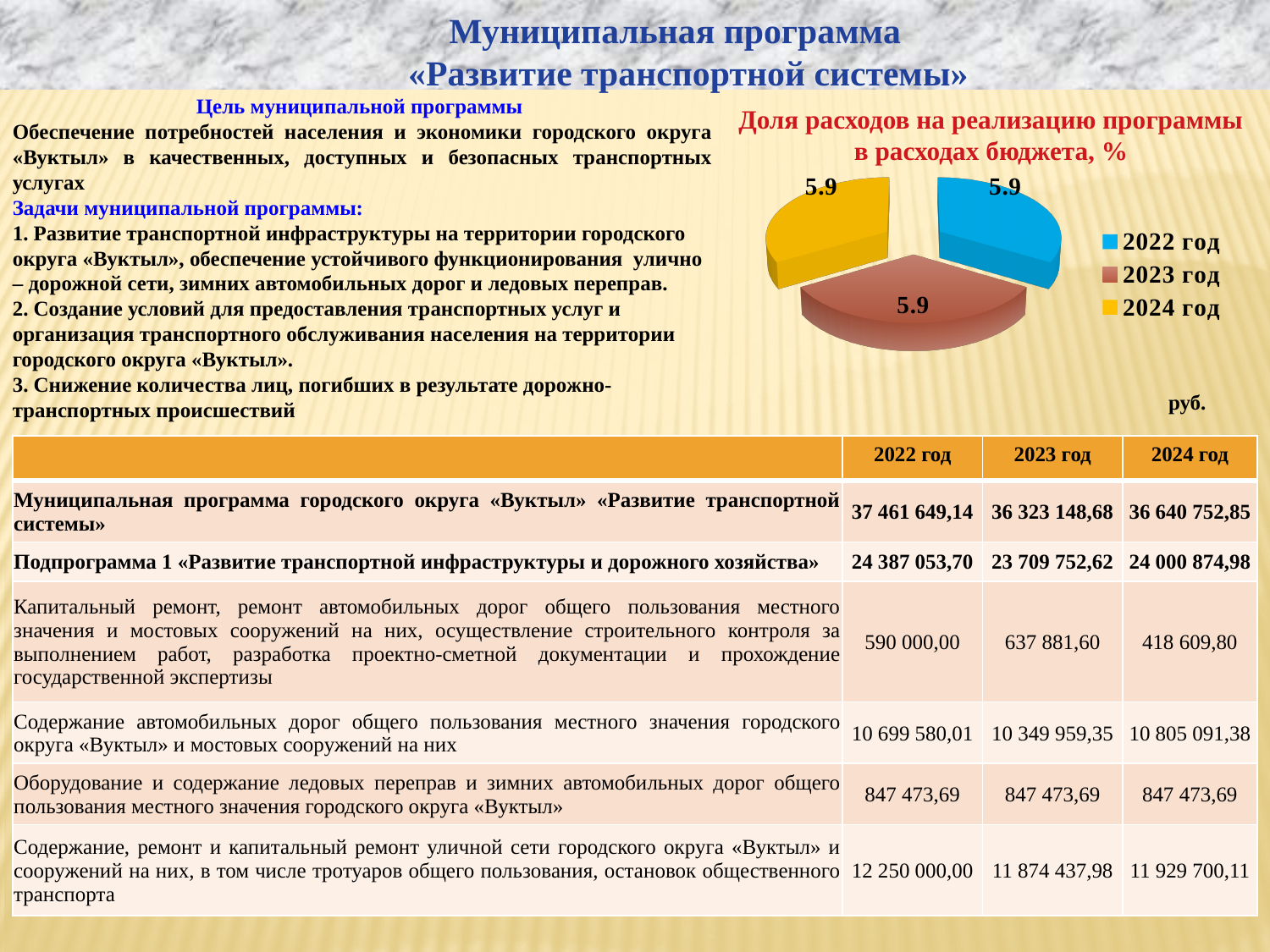
What is the value shown for 2024 год in the pie chart? 5.9 How many slices does the pie chart have? 3 How many entries does the legend of the pie chart list? 3 What is the value shown for 2023 год in the pie chart? 5.9 What is the value shown for 2022 год in the pie chart? 5.9 What is the title of the pie chart? Доля расходов на реализацию программы в расходах бюджета, % What is the difference between the values for 2022 год and 2024 год in the pie chart? 0.0 Which colour represents 2024 год in the pie chart? yellow What kind of chart is shown on the slide? pie chart